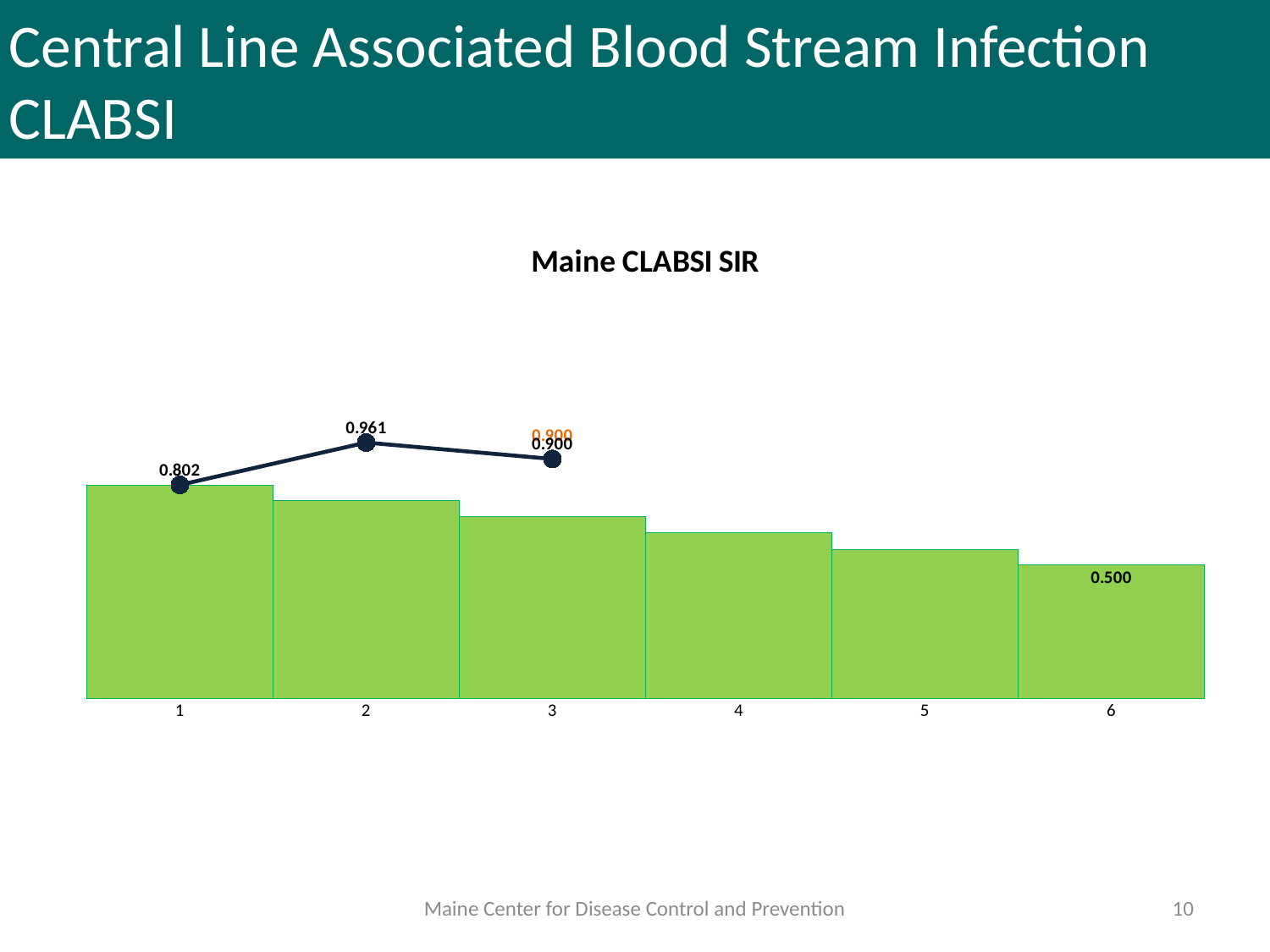
How many bars are shown in the chart? 6 At which category does the line series reach its highest value? 2 Do the green bars rise or fall from category 1 to category 6? Fall What is the value of the line series at category 1? 0.802 What is the value of the line series at category 3? 0.900 What is the value of the line series at category 2? 0.961 Which category has the tallest green bar? 1 Which is larger, the line value at category 2 or at category 3? Category 2 At which category does the line series have its lowest value? 1 What is the difference between the line values at category 2 and category 1? 0.159 What is the title of the chart? Maine CLABSI SIR What is the value labelled on the bar for category 6? 0.500